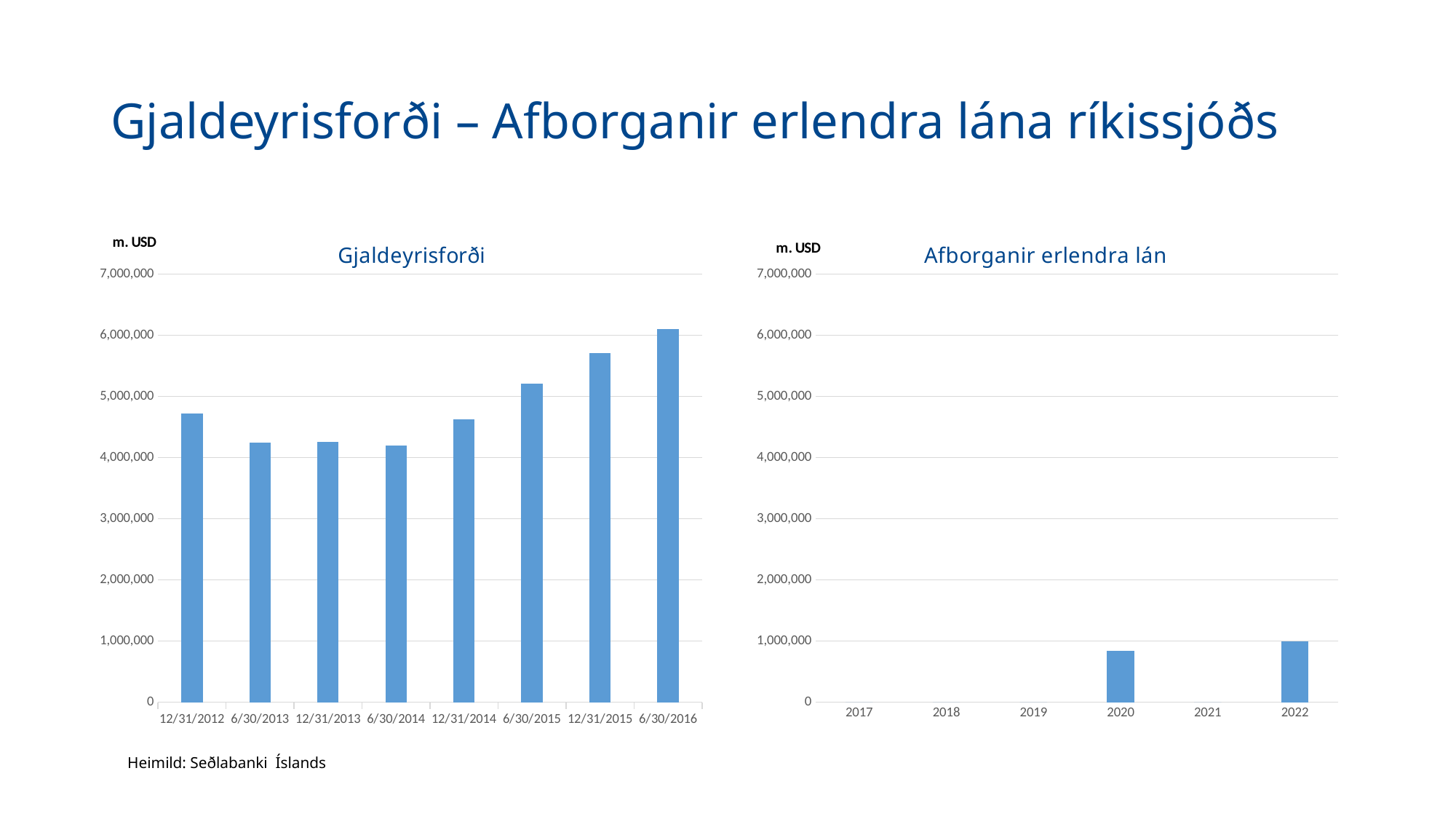
In the Afborganir erlendra lán chart on the right, which years have a visible bar? 2020 and 2022 What unit is shown on the y axis of the Gjaldeyrisforði chart on the left? m. USD How many bars are plotted in the Gjaldeyrisforði chart on the left? 8 In the Gjaldeyrisforði chart on the left, is the value for 12/31/2015 greater or less than 5,000,000? greater In the Gjaldeyrisforði chart on the left, is the value for 6/30/2014 greater or less than 5,000,000? less In the Gjaldeyrisforði chart on the left, which is larger: the value for 6/30/2015 or the value for 12/31/2012? 6/30/2015 In the Gjaldeyrisforði chart on the left, do the values rise or fall from 6/30/2014 to 6/30/2016? rise What kind of chart is the Gjaldeyrisforði chart on the left? bar chart In the Afborganir erlendra lán chart on the right, which year has the highest value? 2022 In the Gjaldeyrisforði chart on the left, which date has the highest value? 6/30/2016 In the Afborganir erlendra lán chart on the right, is the value for 2020 greater or less than 1,000,000? less How many years are listed on the x axis of the Afborganir erlendra lán chart on the right? 6